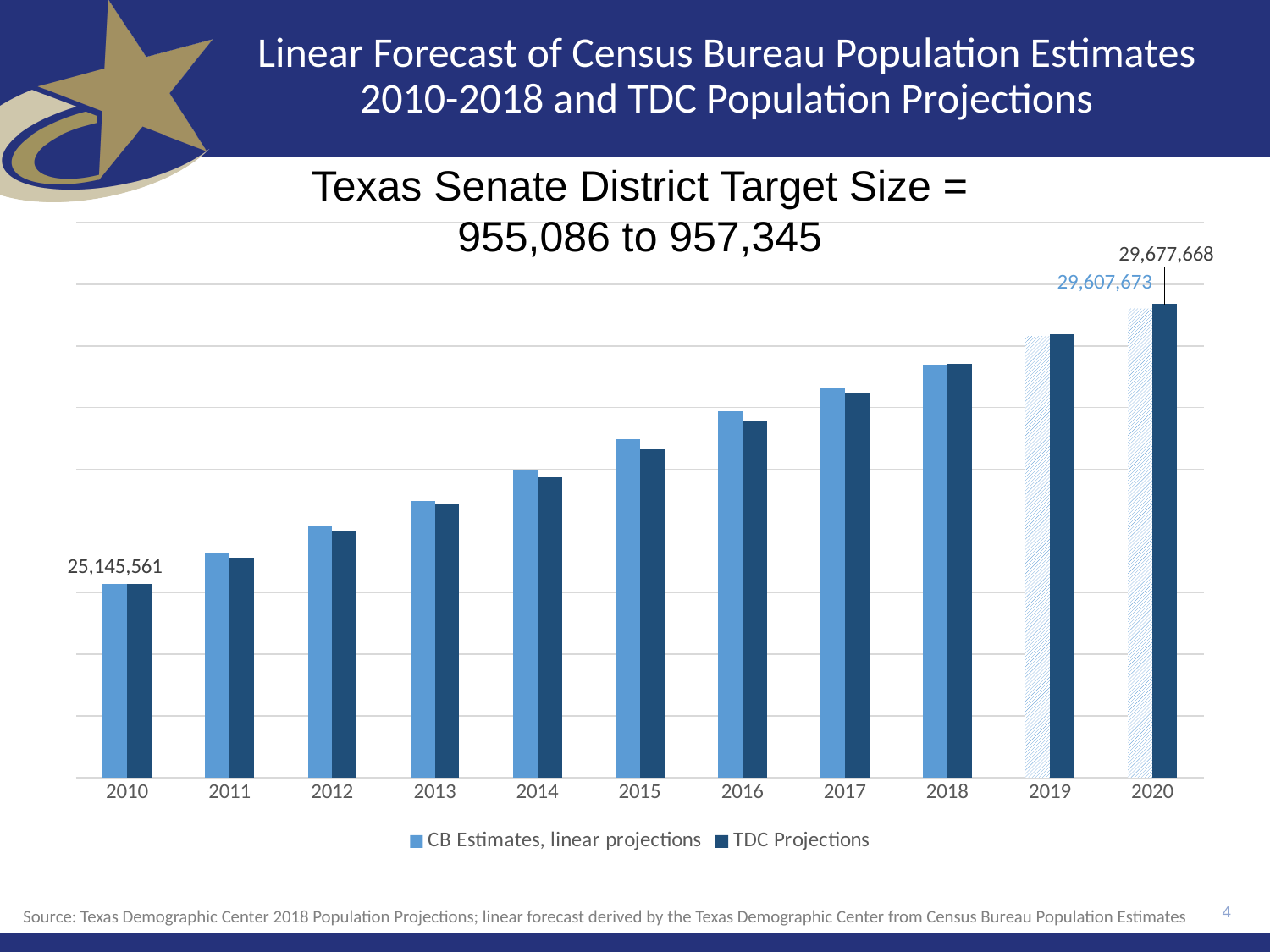
What value is labeled for 2020 in the TDC Projections series? 29,677,668 What type of chart is shown on the slide? bar chart For 2015, which series has the larger value: CB Estimates, linear projections or TDC Projections? CB Estimates, linear projections Which year has the lowest CB Estimates, linear projections value? 2010 How many years are shown on the x axis of the chart? 11 Do the values rise or fall from 2010 to 2020? rise Which year has the highest TDC Projections value? 2020 How many series does the legend list? 2 For 2020, which series has the larger value: CB Estimates, linear projections or TDC Projections? TDC Projections What population value is labeled for 2010? 25,145,561 What is the difference between the TDC Projections value and the CB Estimates value for 2020? 69,995 What value is labeled for 2020 in the CB Estimates, linear projections series? 29,607,673